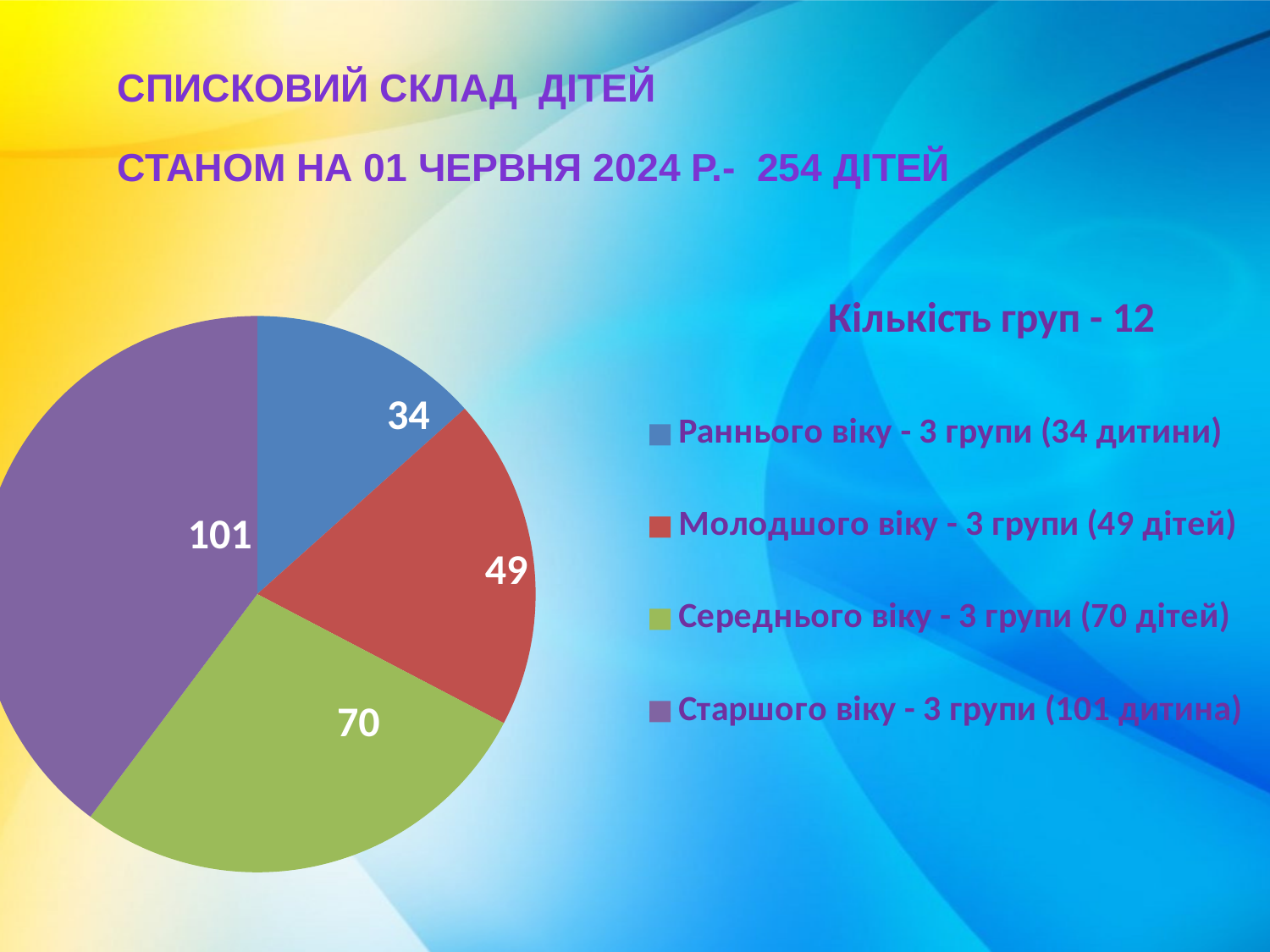
How many slices does the pie chart have? 4 What value is shown for the slice labelled "Старшого віку"? 101 Which category has the smallest slice in the pie chart? Раннього віку What value is shown for the slice labelled "Молодшого віку"? 49 What is the difference between the values for "Старшого віку" and "Раннього віку"? 67 What value is shown for the slice labelled "Раннього віку"? 34 What colour is the slice for "Старшого віку"? purple Which is larger, the value for "Середнього віку" or the value for "Молодшого віку"? Середнього віку What is the total of all the slices in the pie chart? 254 Which category has the largest slice in the pie chart? Старшого віку What value is shown for the slice labelled "Середнього віку"? 70 What type of chart is shown on the slide? pie chart